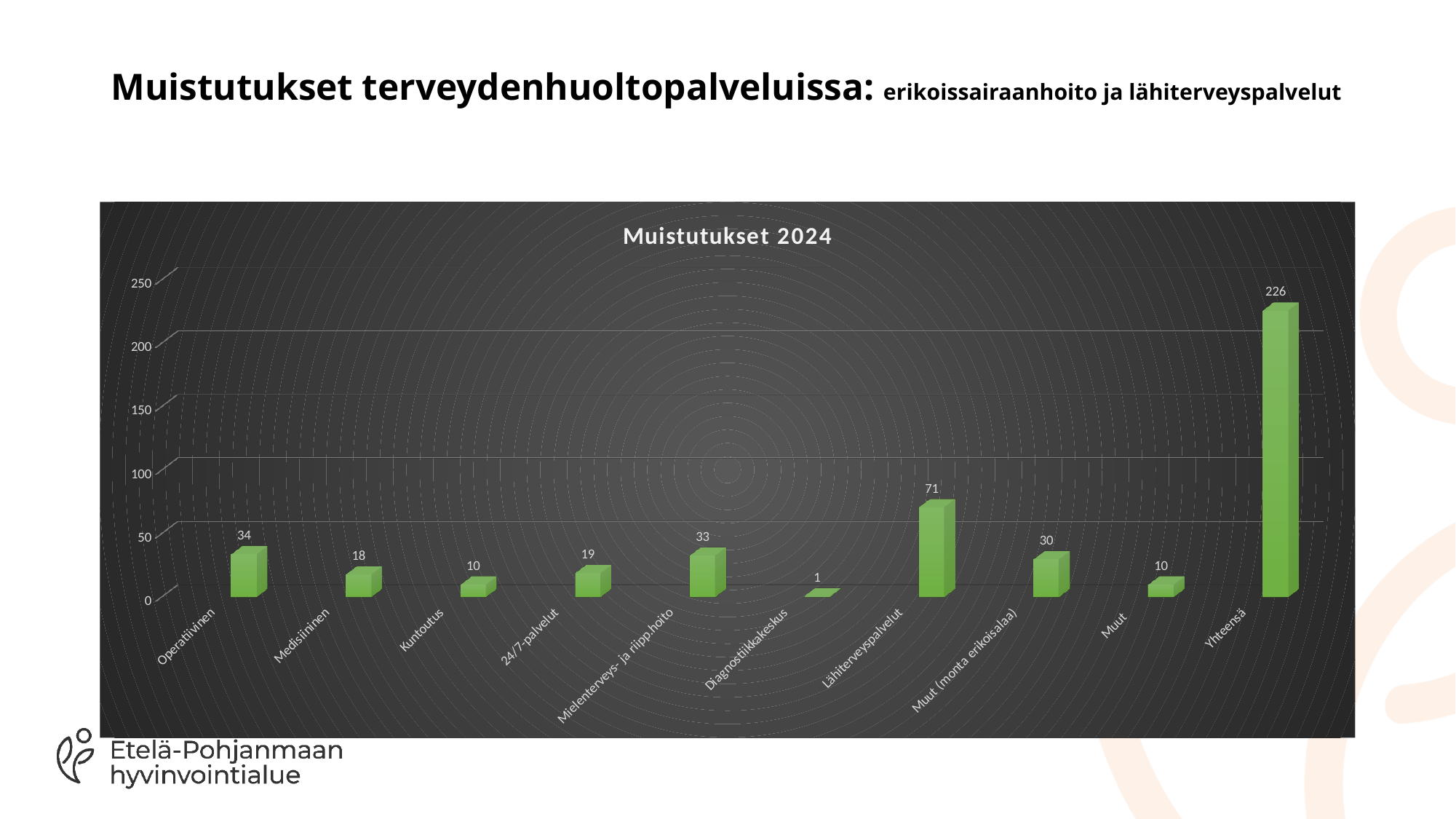
What is the difference between the values for Lähiterveyspalvelut and Operatiivinen? 37 What is the value for Operatiivinen? 34 What is the value for Yhteensä? 226 Which category has the highest value? Yhteensä What is the value for Diagnostiikkakeskus? 1 How many categories are shown on the x axis? 10 What is the title of the chart? Muistutukset 2024 What is the value for Lähiterveyspalvelut? 71 Which is larger, the value for Medisiininen or the value for 24/7-palvelut? 24/7-palvelut What kind of chart is shown? bar chart Is the value for Lähiterveyspalvelut greater or less than 50? greater Which category has the lowest value? Diagnostiikkakeskus